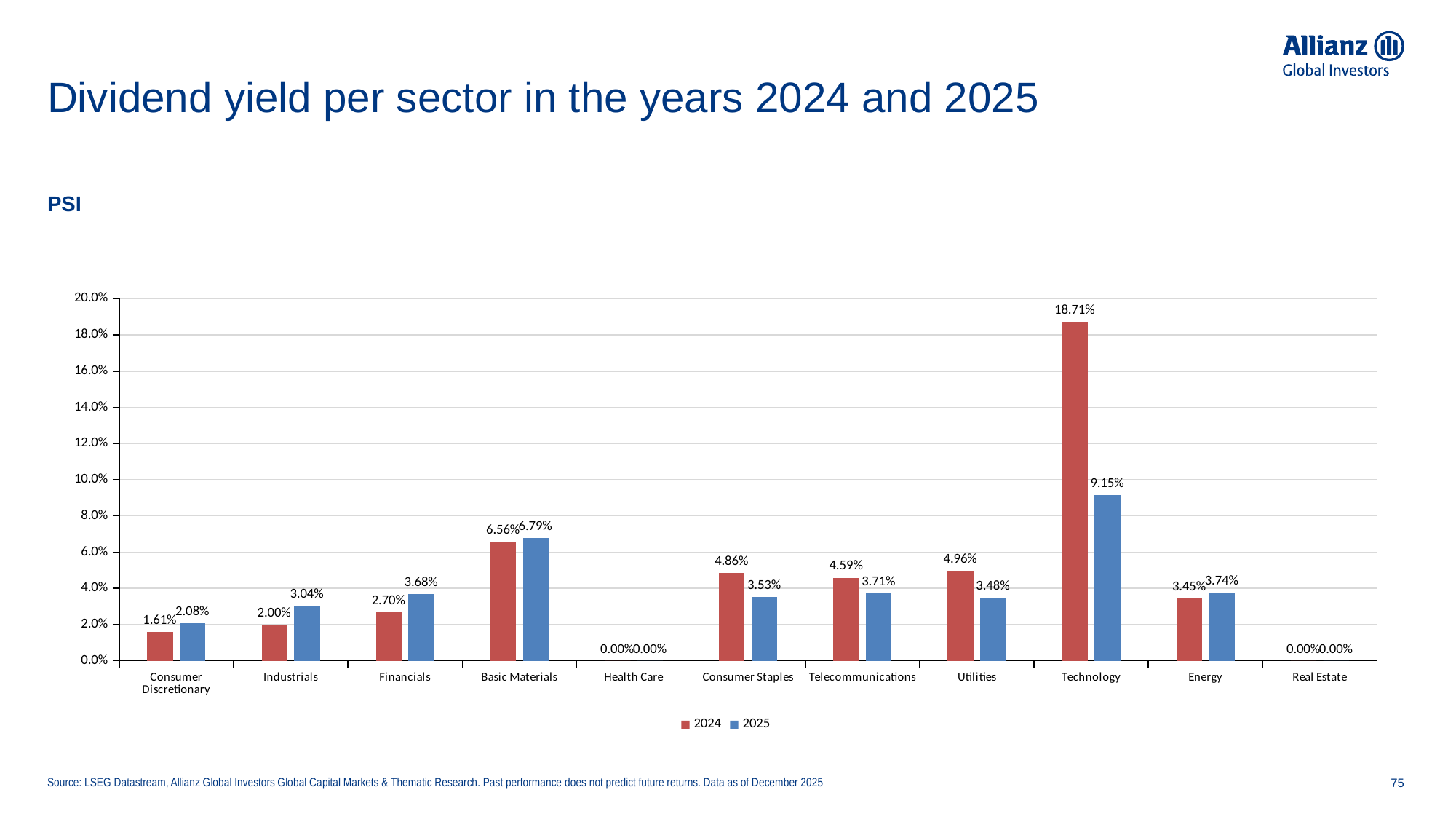
Which sector has the highest dividend yield in 2024? Technology What is the dividend yield for Consumer Staples in 2024? 4.86% Which is larger for Utilities: the 2024 or the 2025 dividend yield? 2024 What is the dividend yield for Financials in 2025? 3.68% Which colour represents the 2025 series in the chart? Blue What kind of chart is shown on the slide? Bar chart Is the 2025 dividend yield for Basic Materials greater or less than 6.0%? greater What is the difference between the 2024 and 2025 dividend yields for Technology? 9.56% How many sectors are shown on the x axis? 11 Which sector has the lowest non-zero dividend yield in 2024? Consumer Discretionary What is the dividend yield for Technology in 2024? 18.71% How many series does the legend list? 2